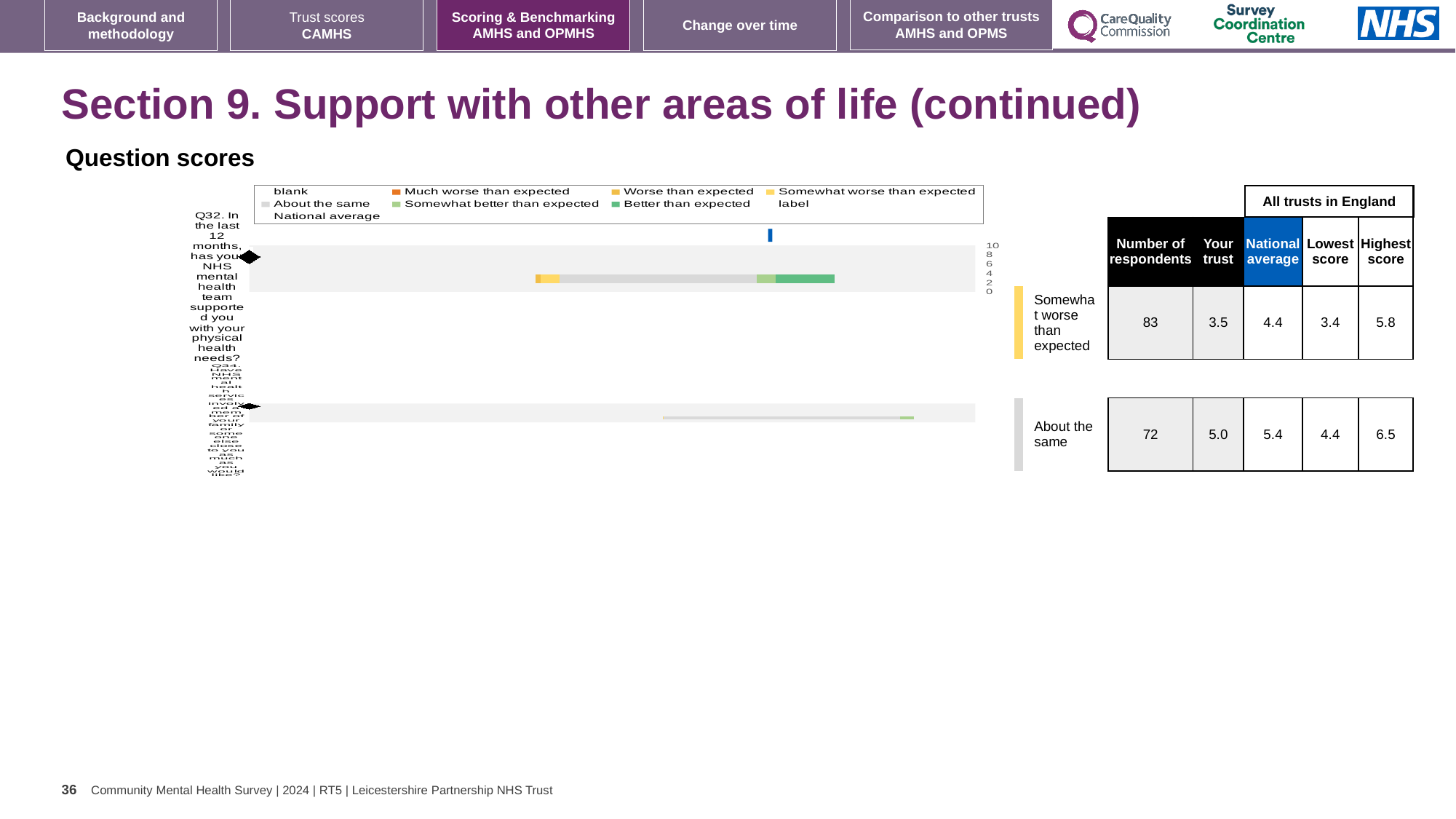
In the table beside the chart, what is the highest score across all trusts in England for Q34? 6.5 What kind of chart is shown under 'Question scores'? bar chart Which legend entry is shown in orange? Much worse than expected In the table beside the chart, what is the 'Your trust' score for Q32? 3.5 In the table beside the chart, which question has the higher 'Your trust' score, Q32 or Q34? Q34 In the table beside the chart, how many respondents answered Q32? 83 In the table beside the chart, what is the national average for Q34? 5.4 How many entries does the chart legend list? 9 What is the highest value shown on the chart's numeric axis? 10 What benchmark category is given for Q32 next to the chart? Somewhat worse than expected In the table beside the chart, what is the difference between the national average and the 'Your trust' score for Q32? 0.9 How many questions (categories) are plotted in the chart? 2